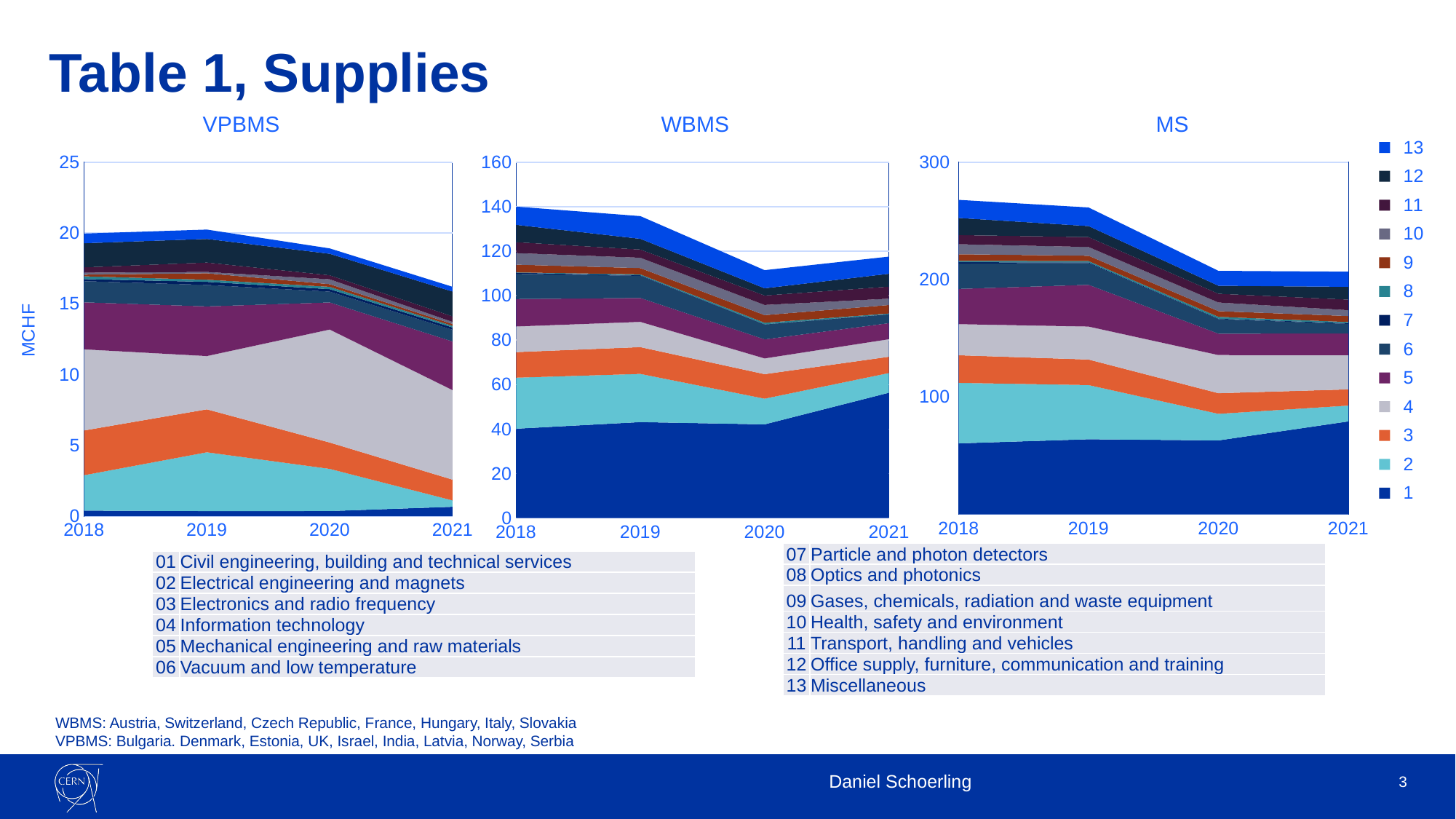
What kind of chart is the VPBMS chart? stacked area chart In the MS chart, is the total value for 2018 greater or less than 250? greater How many years are plotted along the x axis of the WBMS chart? 4 In the WBMS chart, which year has the lowest total value? 2020 In the VPBMS chart, does the total value rise or fall from 2019 to 2021? fall In the VPBMS chart, is the total value for 2021 greater or less than 20? less What unit is shown on the y axis label of the VPBMS chart? MCHF How many series does the legend list? 13 In the VPBMS chart, which year has the lowest total value? 2021 In the MS chart, is the total value for 2021 greater or less than 250? less In the MS chart, does the total value rise or fall from 2018 to 2021? fall